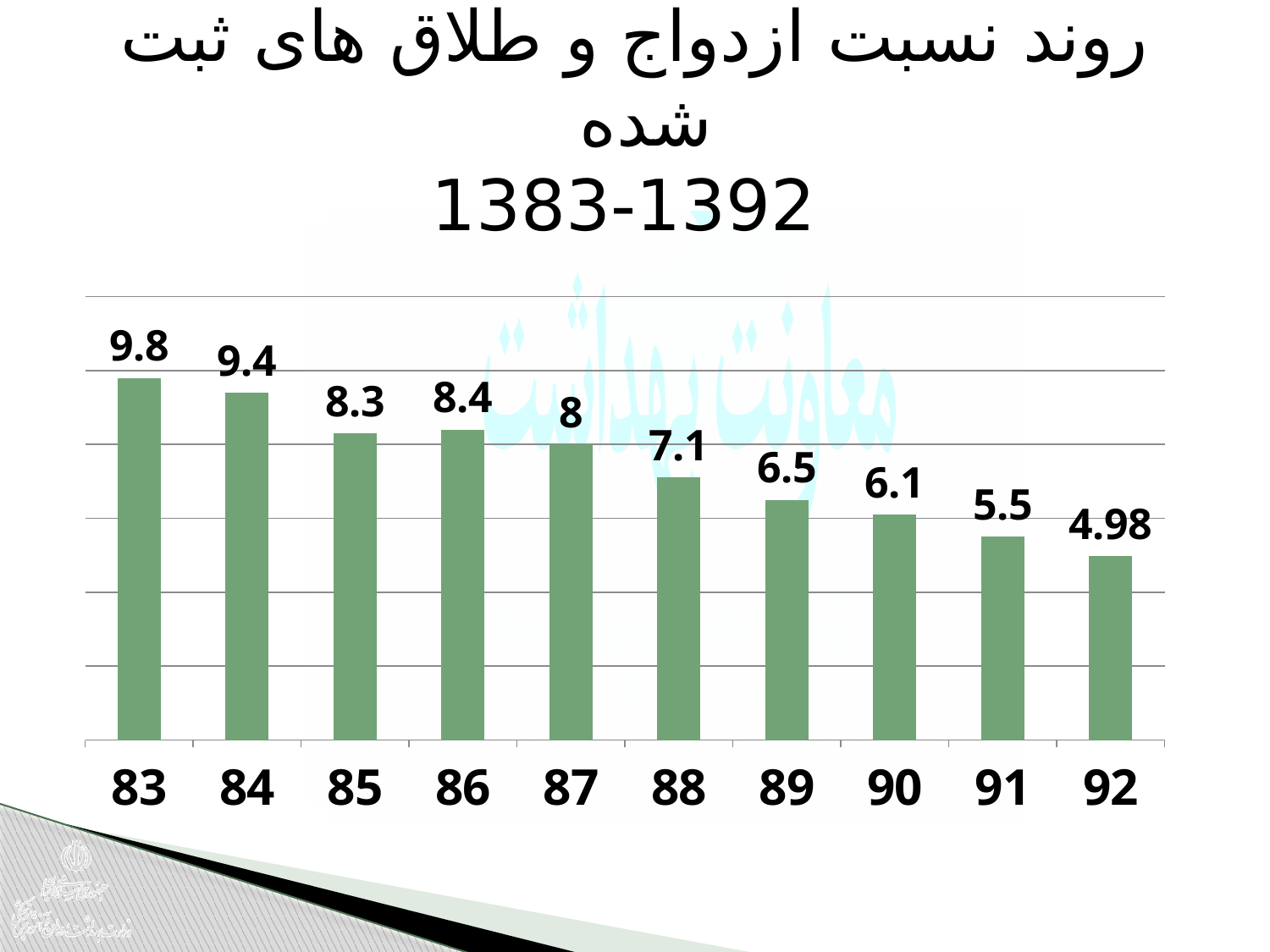
How many years are shown on the x axis? 10 What is the difference between the values for 83 and 92? 4.82 Which year has the highest value? 83 Which is larger, the value for 89 or the value for 90? 89 What kind of chart is this? bar chart Do the values generally rise or fall from 83 to 92? fall What is the value for 83? 9.8 What is the value for 88? 7.1 What is the value for 92? 4.98 What is the value for 87? 8 What is the difference between the values for 86 and 85? 0.1 Which year has the lowest value? 92